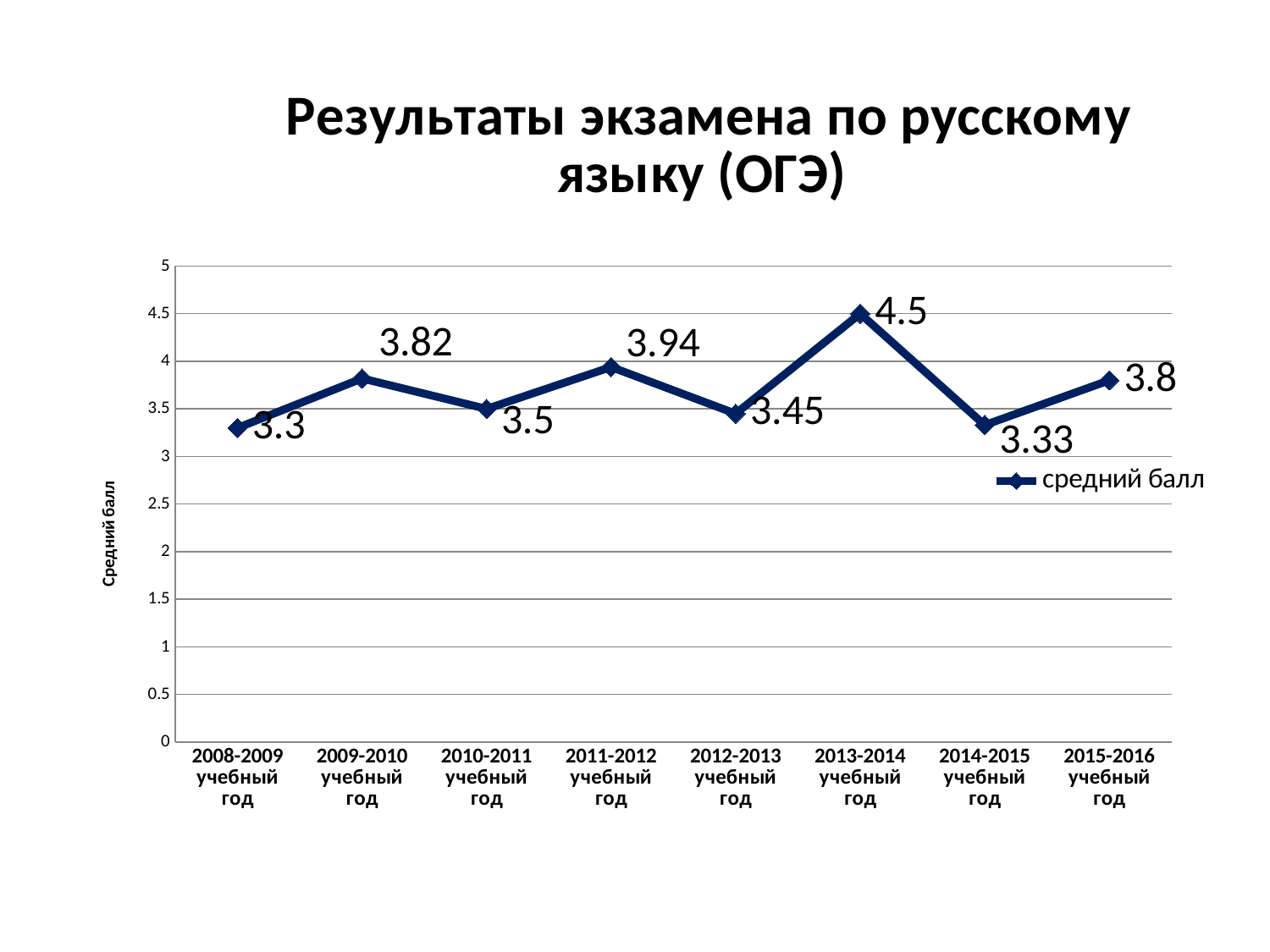
How many series does the legend list? 1 Which is larger, the average score for 2009-2010 or for 2010-2011? 2009-2010 учебный год Which academic year has the highest average score? 2013-2014 учебный год What is the average score for the 2008-2009 учебный год? 3.3 What is the difference between the average scores for 2013-2014 and 2014-2015? 1.17 What is the average score for the 2011-2012 учебный год? 3.94 Is the value for 2013-2014 учебный год greater or less than 4? greater What is the title of the chart? Результаты экзамена по русскому языку (ОГЭ) Which academic year has the lowest average score? 2008-2009 учебный год How many academic years are plotted on the chart? 8 What kind of chart is shown on the slide? line chart What is the average score for the 2013-2014 учебный год? 4.5